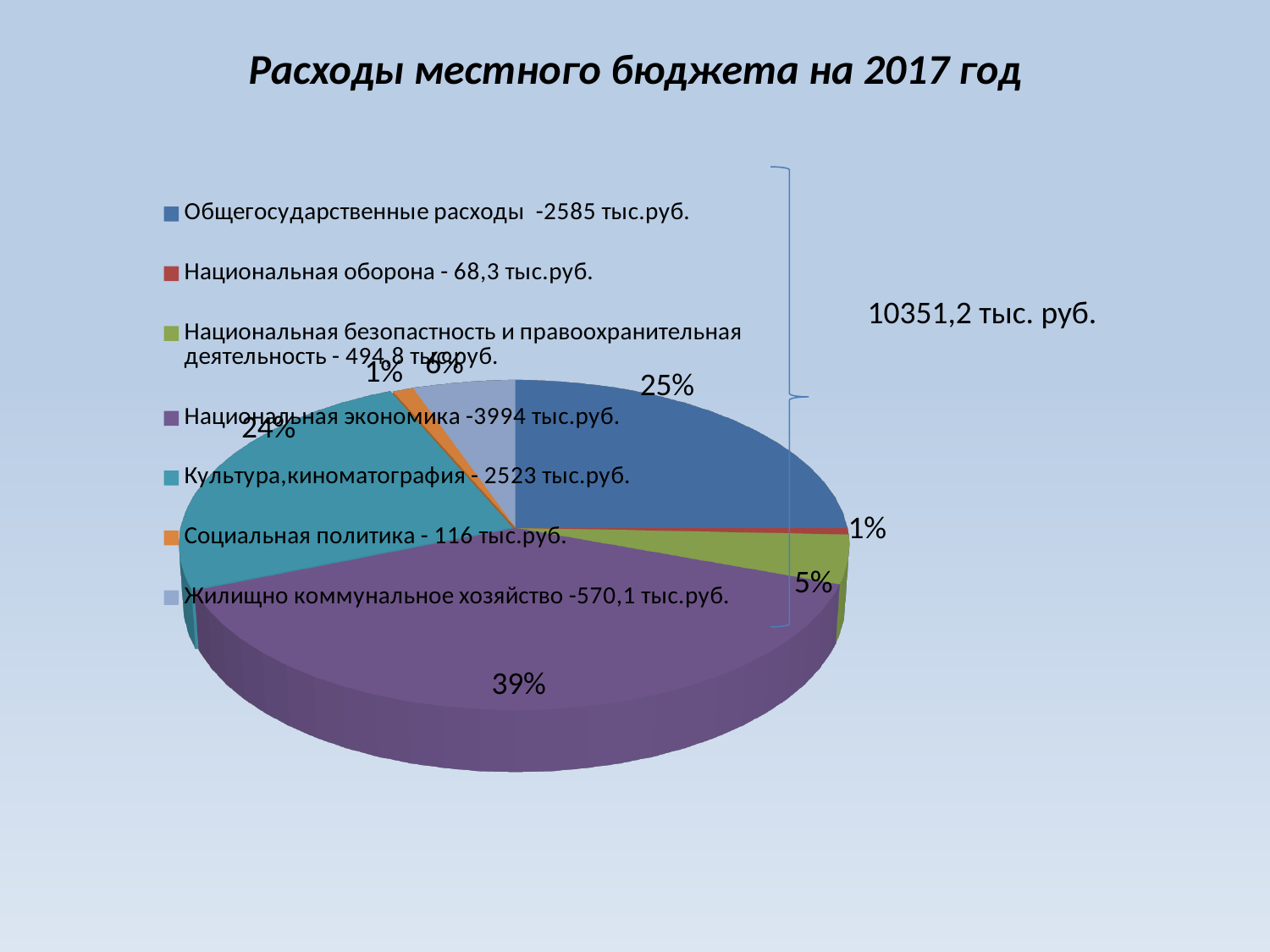
Which is larger according to the legend amounts: Общегосударственные расходы or Культура,киноматография? Общегосударственные расходы What kind of chart is shown on the slide? pie chart What is the total amount of expenditures shown on the slide? 10351,2 тыс. руб. What is the title of the chart? Расходы местного бюджета на 2017 год What share of the pie does Национальная экономика take? 39% What share of the pie does Жилищно коммунальное хозяйство take? 6% How many categories does the pie chart have? 7 According to the legend, what is the amount for Национальная оборона? 68,3 тыс.руб. Which category has the smallest amount listed in the legend? Национальная оборона What share of the pie does Общегосударственные расходы take? 25% Which category has the largest slice of the pie? Национальная экономика According to the legend, what is the amount for Культура,киноматография? 2523 тыс.руб.